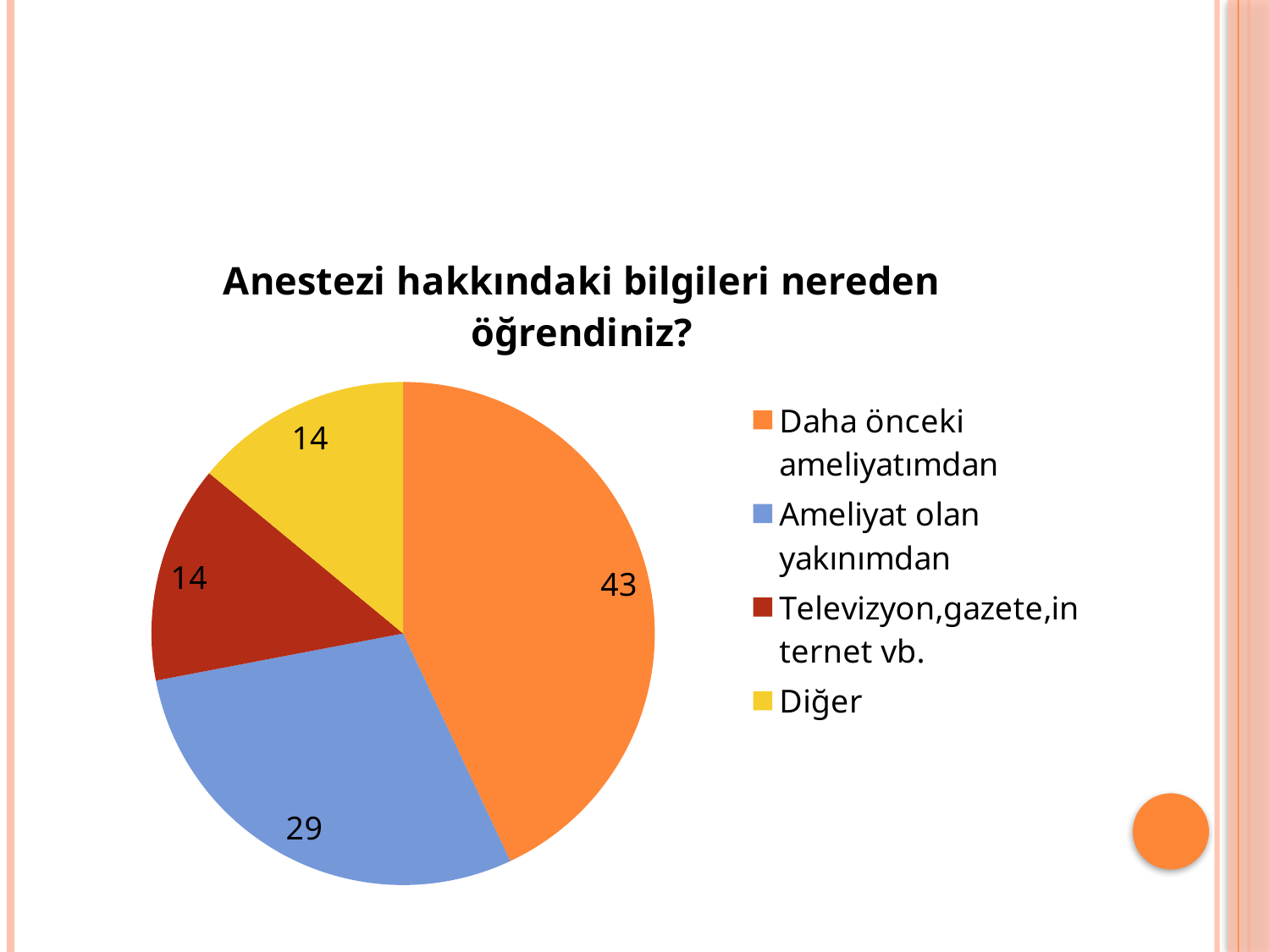
Which category has the largest slice of the pie? Daha önceki ameliyatımdan What value is shown for the "Diğer" slice? 14 What is the title of the chart? Anestezi hakkındaki bilgileri nereden öğrendiniz? What value is shown for the "Daha önceki ameliyatımdan" slice? 43 What is the total of all the slice values in the pie chart? 100 What kind of chart is shown on the slide? Pie chart What value is shown for the "Ameliyat olan yakınımdan" slice? 29 What is the difference between the values for "Ameliyat olan yakınımdan" and "Diğer"? 15 What is the difference between the values for "Daha önceki ameliyatımdan" and "Ameliyat olan yakınımdan"? 14 What value is shown for the "Televizyon,gazete,internet vb." slice? 14 How many categories does the pie chart show? 4 Which is larger, the value for "Ameliyat olan yakınımdan" or the value for "Diğer"? Ameliyat olan yakınımdan